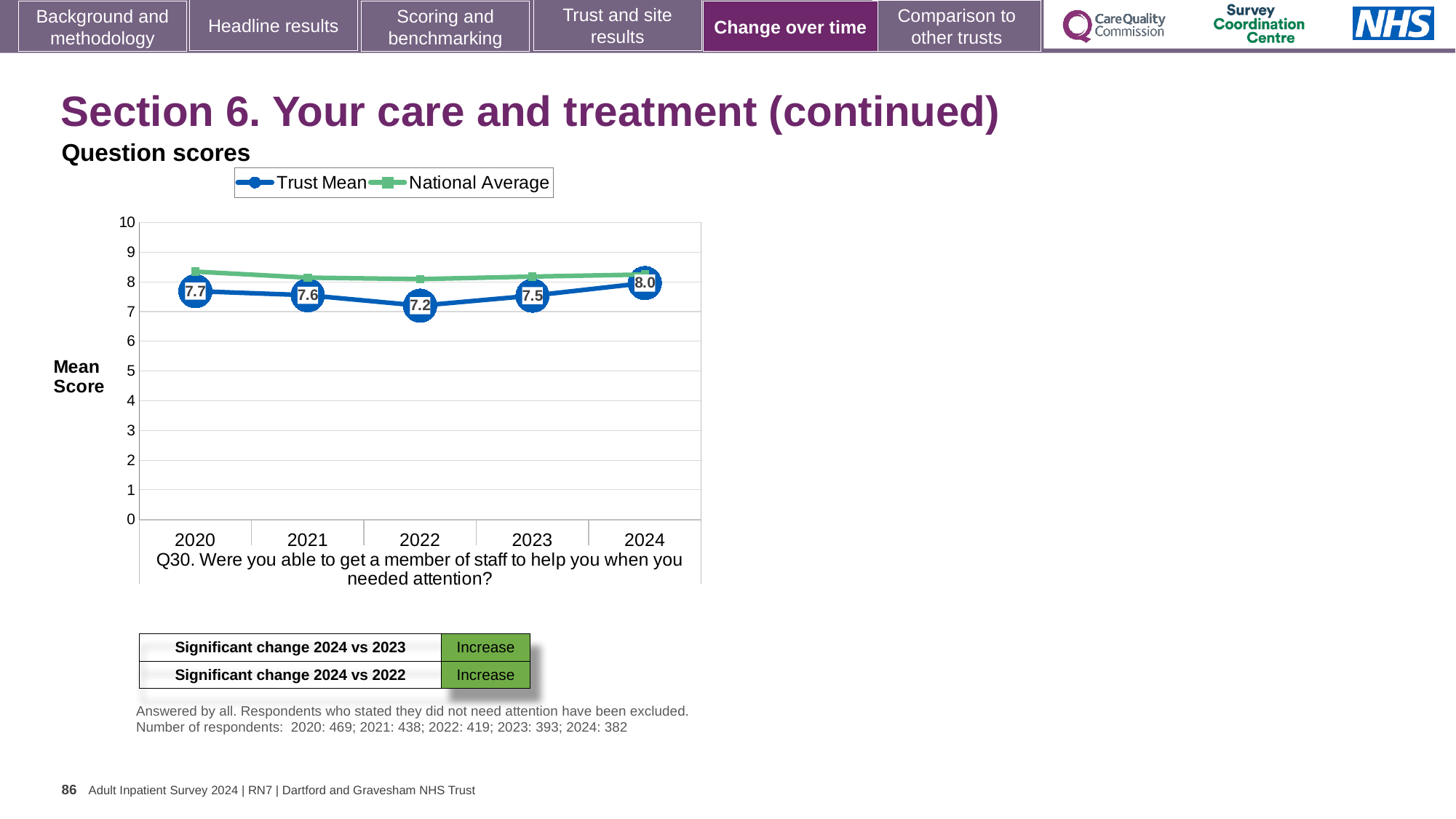
What kind of chart is shown? Line chart What is the Trust Mean score for 2022? 7.2 How many series does the legend list? 2 What is the difference between the Trust Mean scores for 2024 and 2022? 0.8 Which year has the highest Trust Mean score? 2024 What is the Trust Mean score for 2024? 8.0 Which year has the lowest Trust Mean score? 2022 What is the Trust Mean score for 2020? 7.7 Is the National Average value for 2020 greater or less than 8? greater Which is larger, the Trust Mean score for 2021 or for 2023? 2021 Does the Trust Mean rise or fall from 2022 to 2024? Rise How many years are plotted on the x axis? 5